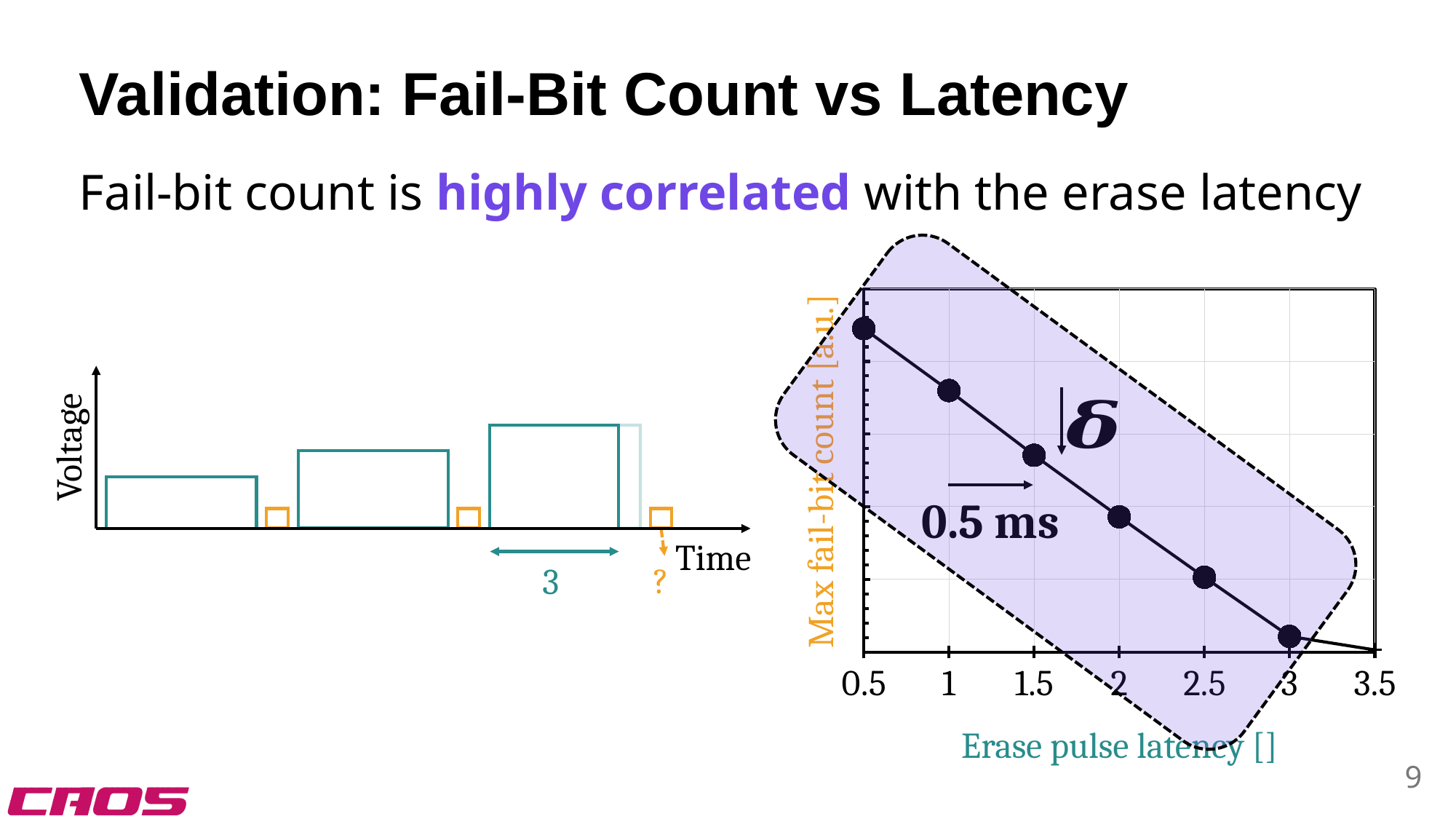
In the chart on the right, is the max fail-bit count larger at an erase pulse latency of 2 or of 1.5? 1.5 In the chart on the right, does the max fail-bit count rise or fall as erase pulse latency increases? fall What is the label of the x axis of the chart on the right? Erase pulse latency [] In the chart on the right, what is the smallest value shown on the x axis? 0.5 In the chart on the right, at which erase pulse latency is the max fail-bit count highest? 0.5 In the chart on the right, is the max fail-bit count larger at an erase pulse latency of 1 or of 2.5? 1 In the chart on the right, what spacing between points is indicated by the horizontal arrow annotation? 0.5 ms What is the label of the y axis of the chart on the right? Max fail-bit count [a.u.] In the chart on the right, what is the largest value shown on the x axis? 3.5